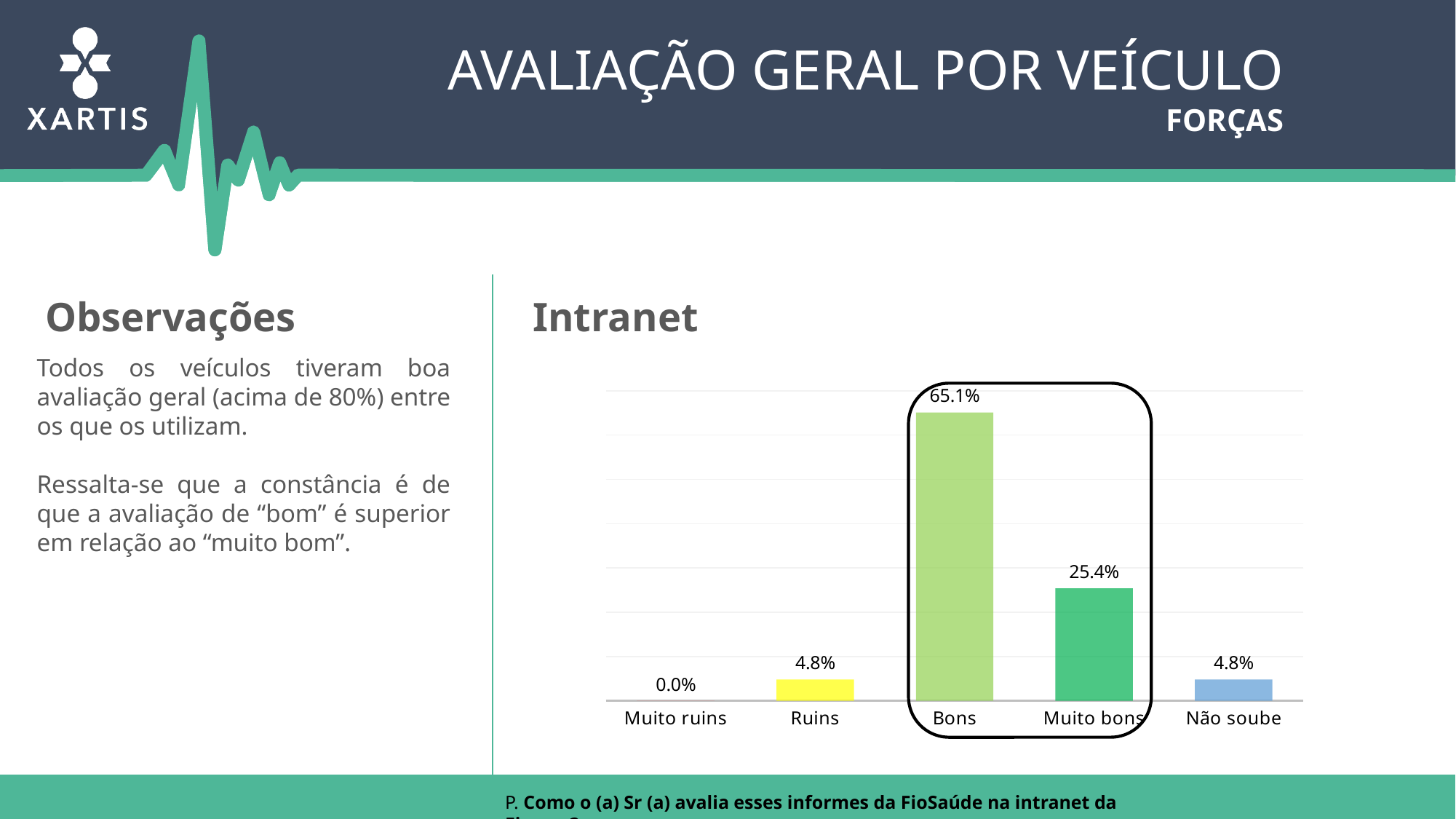
How many categories are shown on the x axis? 5 What is the title of the chart? Intranet Which category has the highest value? Bons Which category has the lowest value? Muito ruins What kind of chart is shown? Bar chart What is the value for Não soube? 4.8% What is the value for Bons? 65.1% What is the difference between the values for Bons and Muito bons? 39.7% What is the value for Muito ruins? 0.0% What is the value for Muito bons? 25.4% Which is larger, the value for Muito bons or the value for Ruins? Muito bons What is the value for Ruins? 4.8%